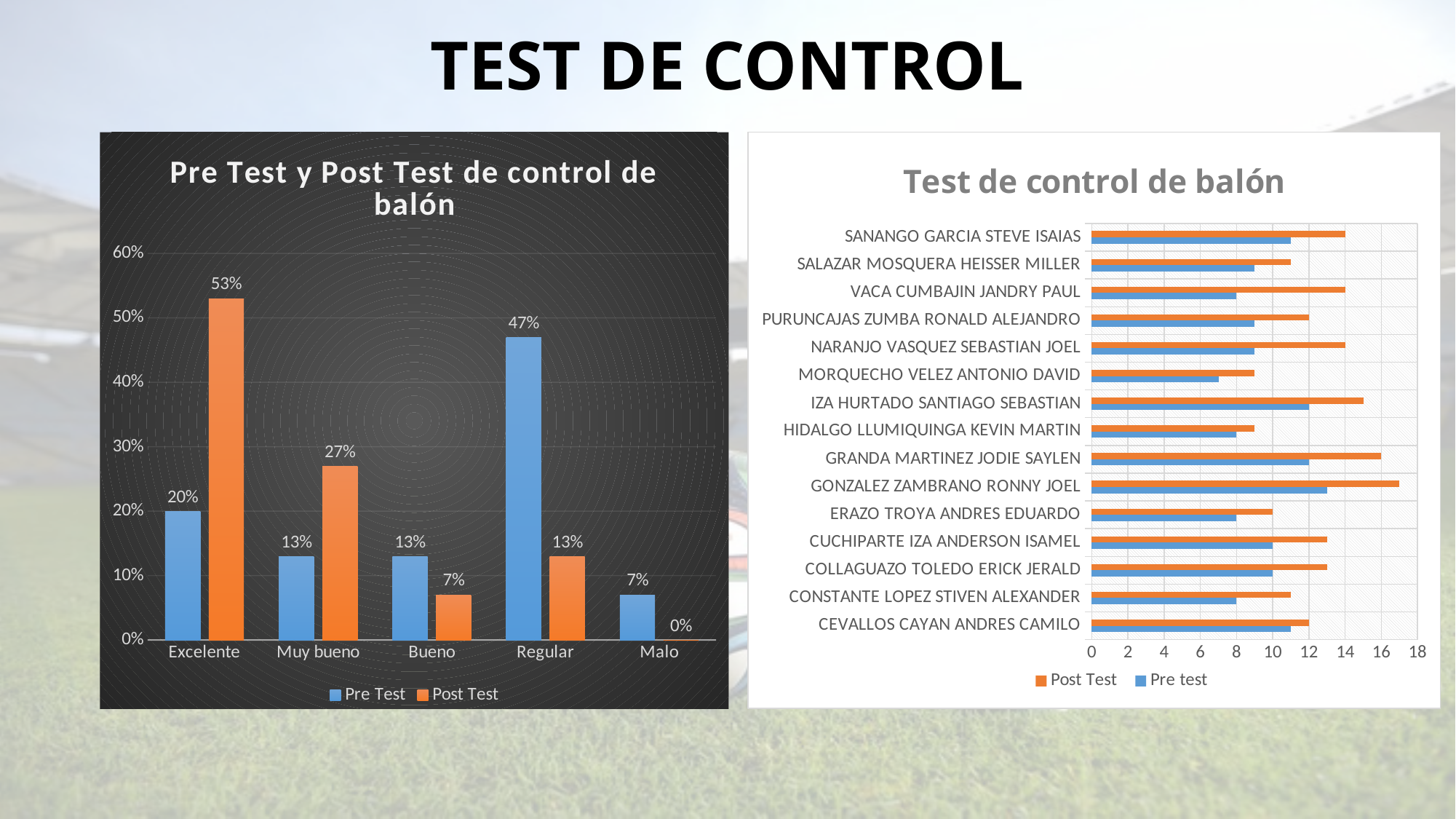
In the chart titled 'Pre Test y Post Test de control de balón', what is the difference between the Post Test and Pre Test values for Excelente? 33% In the chart titled 'Pre Test y Post Test de control de balón', which category has the highest Pre Test value? Regular In the chart titled 'Pre Test y Post Test de control de balón', what is the Post Test value for Malo? 0% In the chart titled 'Test de control de balón', how many players are listed? 15 In the chart titled 'Pre Test y Post Test de control de balón', how many categories are shown on the x axis? 5 In the chart titled 'Pre Test y Post Test de control de balón', what is the Pre Test value for Regular? 47% In the chart titled 'Test de control de balón', is the Post Test value for IZA HURTADO SANTIAGO SEBASTIAN greater or less than 14? greater What kind of chart is the one titled 'Test de control de balón'? Bar chart In the chart titled 'Test de control de balón', which player has the highest Post Test value? GONZALEZ ZAMBRANO RONNY JOEL In the chart titled 'Pre Test y Post Test de control de balón', which is larger for Bueno, the Pre Test or the Post Test value? Pre Test In the chart titled 'Test de control de balón', is the Pre test value for MORQUECHO VELEZ ANTONIO DAVID greater or less than 8? less In the chart titled 'Pre Test y Post Test de control de balón', what is the Post Test value for Excelente? 53%